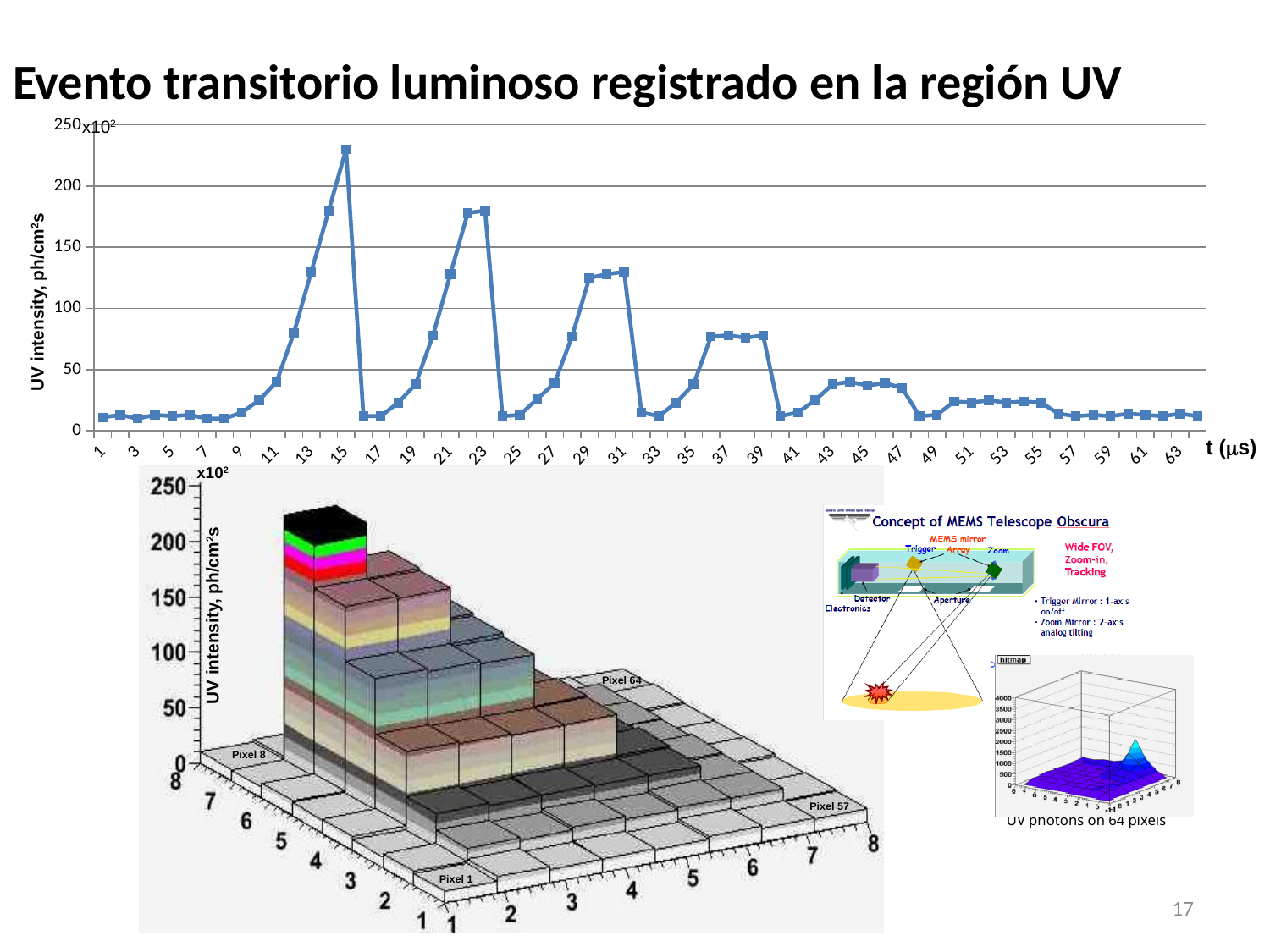
What is the y-axis title of the top chart? UV intensity, ph/cm²s In the top chart, is the value at t = 30 greater or less than 100? greater In the top chart, is the value at t = 16 greater or less than 50? less In the top chart, is the value at t = 37 greater or less than 50? greater In the top line chart, at which value of t does the UV intensity reach its highest point? 15 In the top chart, which is larger: the value at t = 15 or the value at t = 23? t = 15 What kind of chart is the top chart on the slide? line chart In the top chart, which is larger: the value at t = 23 or the value at t = 30? t = 23 In the top chart, do the values rise or fall from t = 9 to t = 15? rise